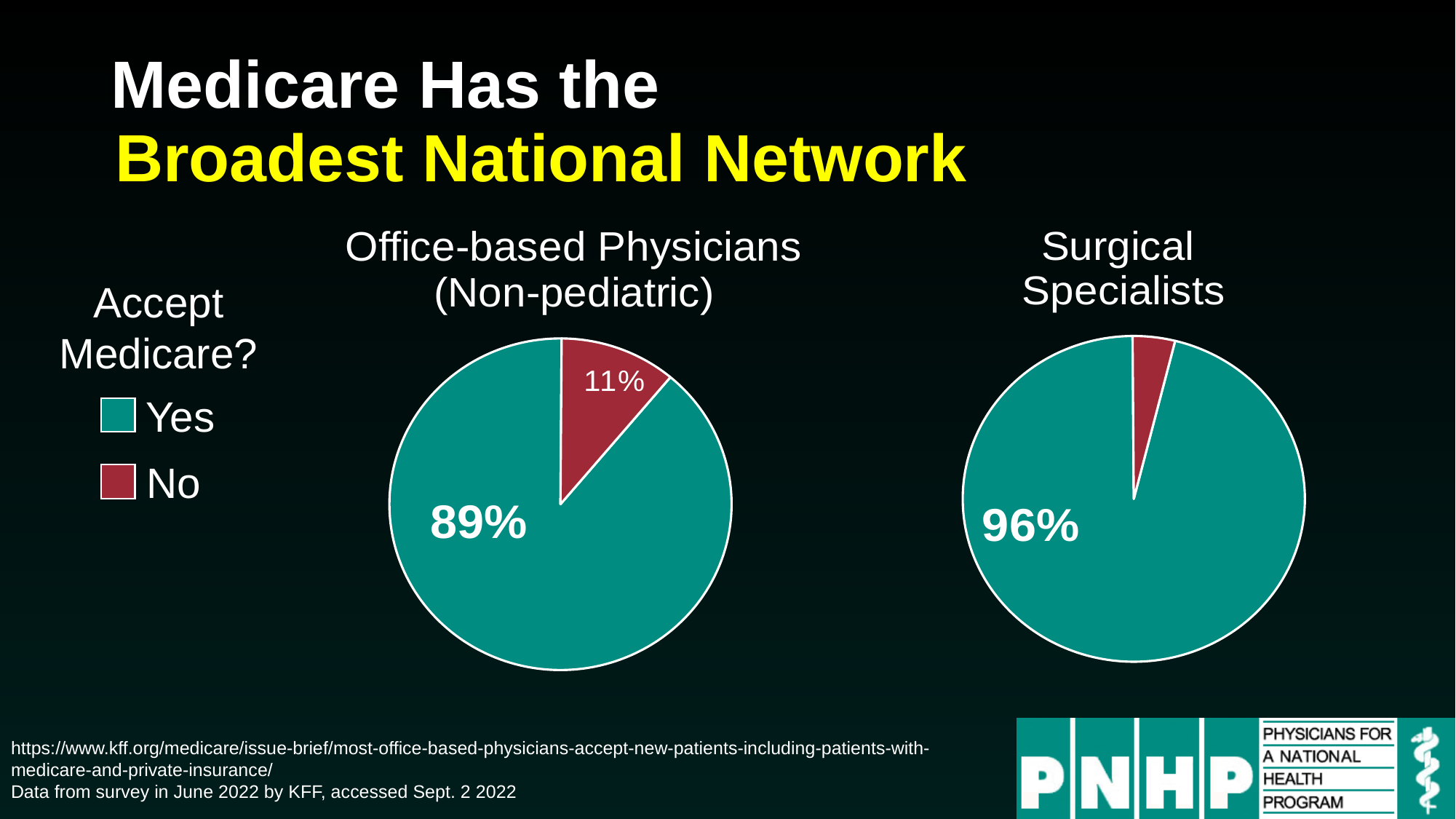
How many categories does the legend list for the pie charts? 2 In the Office-based Physicians (Non-pediatric) pie chart, what percentage do not accept Medicare (No)? 11% How many slices does the Surgical Specialists pie chart have? 2 In the Surgical Specialists pie chart, which slice is the smallest? No In the Office-based Physicians (Non-pediatric) pie chart, what is the difference in percentage points between the Yes and No slices? 78 percentage points Which pie chart shows the higher Yes share, Office-based Physicians (Non-pediatric) or Surgical Specialists? Surgical Specialists In the Office-based Physicians (Non-pediatric) pie chart, what percentage of physicians accept Medicare (Yes)? 89% In the Office-based Physicians (Non-pediatric) pie chart, which slice is larger, Yes or No? Yes What colour represents the Yes category in the pie charts? Teal What question does the legend say the pie charts answer? Accept Medicare? In the Surgical Specialists pie chart, what percentage accept Medicare (Yes)? 96% What kind of chart is used for the Office-based Physicians (Non-pediatric) data? Pie chart